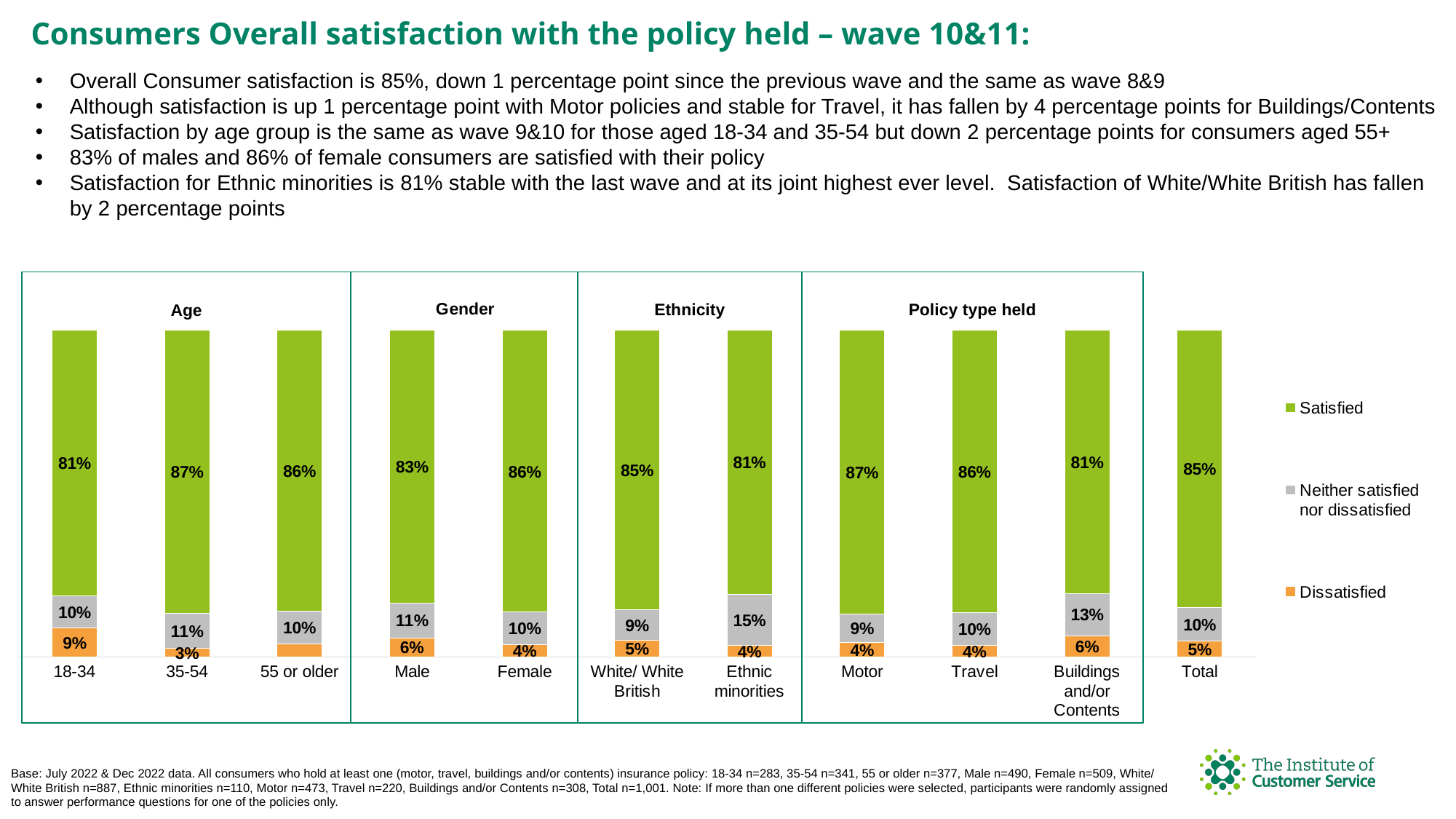
How many series does the legend list? 3 How many categories are shown on the x axis of the chart? 11 What is the Dissatisfied value for Buildings and/or Contents? 6% What percentage of consumers aged 18-34 are satisfied? 81% Which category has the highest Neither satisfied nor dissatisfied value? Ethnic minorities What is the Neither satisfied nor dissatisfied value for Ethnic minorities? 15% What kind of chart is shown on the slide? Stacked bar chart Which category has the highest Dissatisfied value? 18-34 Which has a higher Satisfied value, Motor or Buildings and/or Contents? Motor What is the difference between the Satisfied values for Female and Male? 3% What is the Satisfied value for Total? 85% Which category has the lowest Dissatisfied value? 35-54